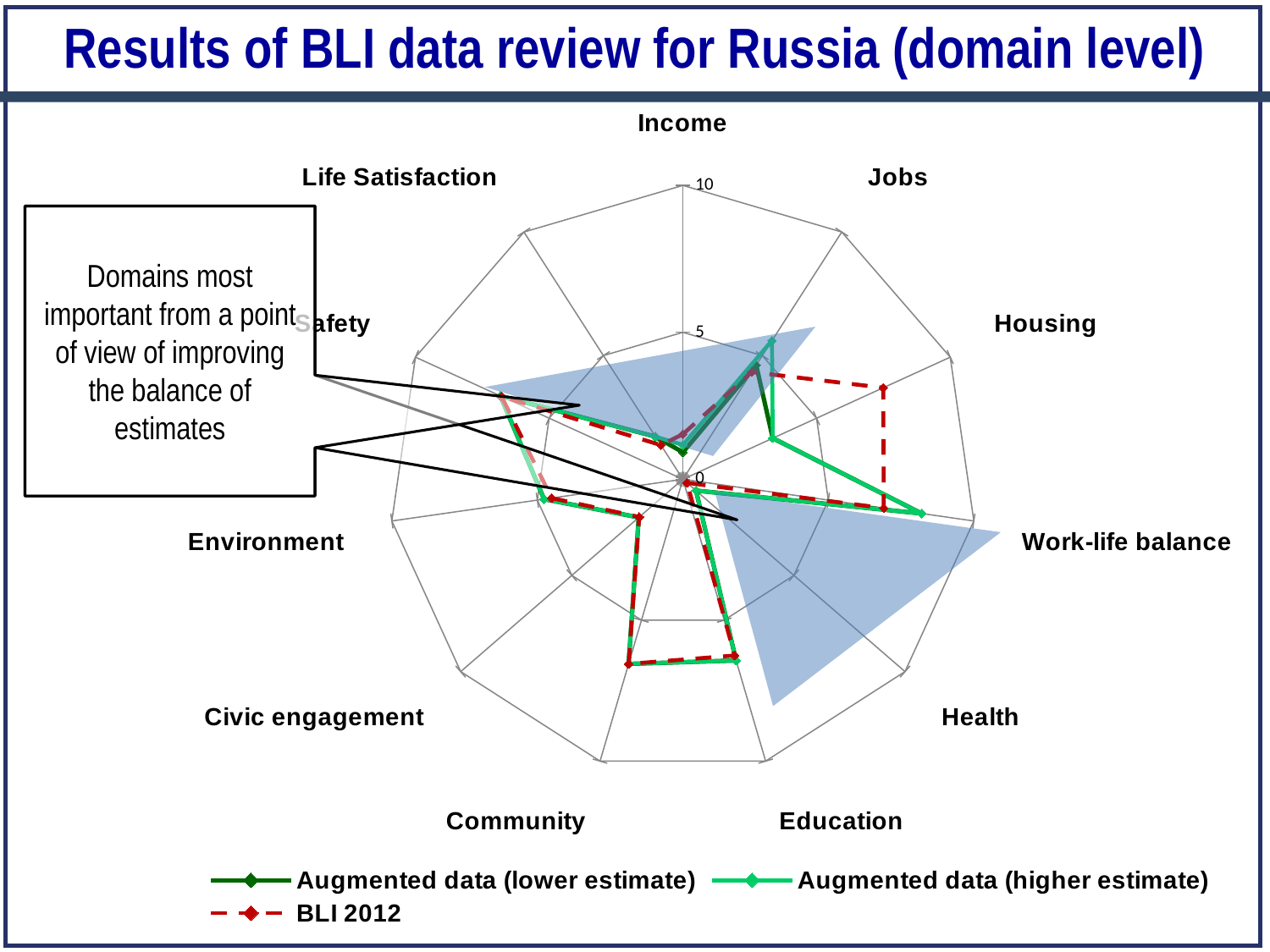
Is the BLI 2012 value for Housing greater or less than 5? greater Is the Augmented data (lower estimate) value for Income greater or less than 5? less How many domains (categories) are plotted around the radar chart? 11 Is the Augmented data (higher estimate) value for Work-life balance greater or less than 5? greater For Work-life balance, which series has the larger value: Augmented data (higher estimate) or BLI 2012? Augmented data (higher estimate) For Housing, which series has the larger value: BLI 2012 or Augmented data (higher estimate)? BLI 2012 Which series is drawn with a red dashed line in the legend? BLI 2012 What is the title of the slide containing the chart? Results of BLI data review for Russia (domain level) What is the maximum value shown on the radar chart's axis? 10 What kind of chart is shown on the slide? Radar chart How many series does the legend list? 3